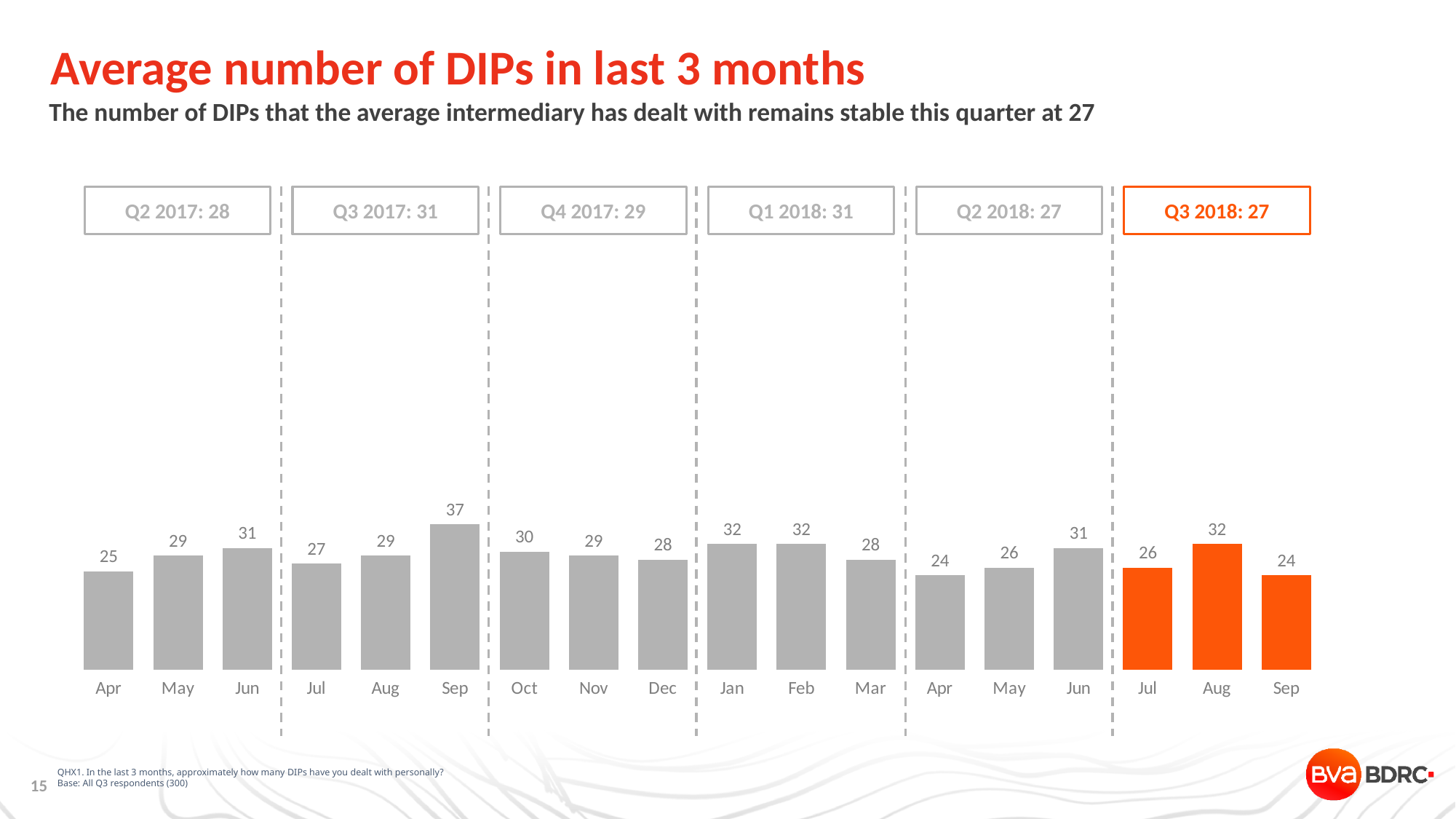
What is the value for Apr in Q2 2017? 25 What is the value for Sep in Q3 2017? 37 Do the values rise or fall from Apr to Jun in Q2 2018? Rise What is the value for Aug in Q3 2018? 32 What kind of chart is shown on the slide? Bar chart What is the difference between the values for Sep and Jul in Q3 2017? 10 What is the value for Feb in Q1 2018? 32 How many monthly bars are plotted on the chart? 18 Which month has the highest value on the chart? Sep (Q3 2017) What is the difference between the values for Aug and Sep in Q3 2018? 8 Which is larger, the value for Jul 2018 or the value for Aug 2018? Aug 2018 What quarterly average is shown in the highlighted orange box for Q3 2018? 27